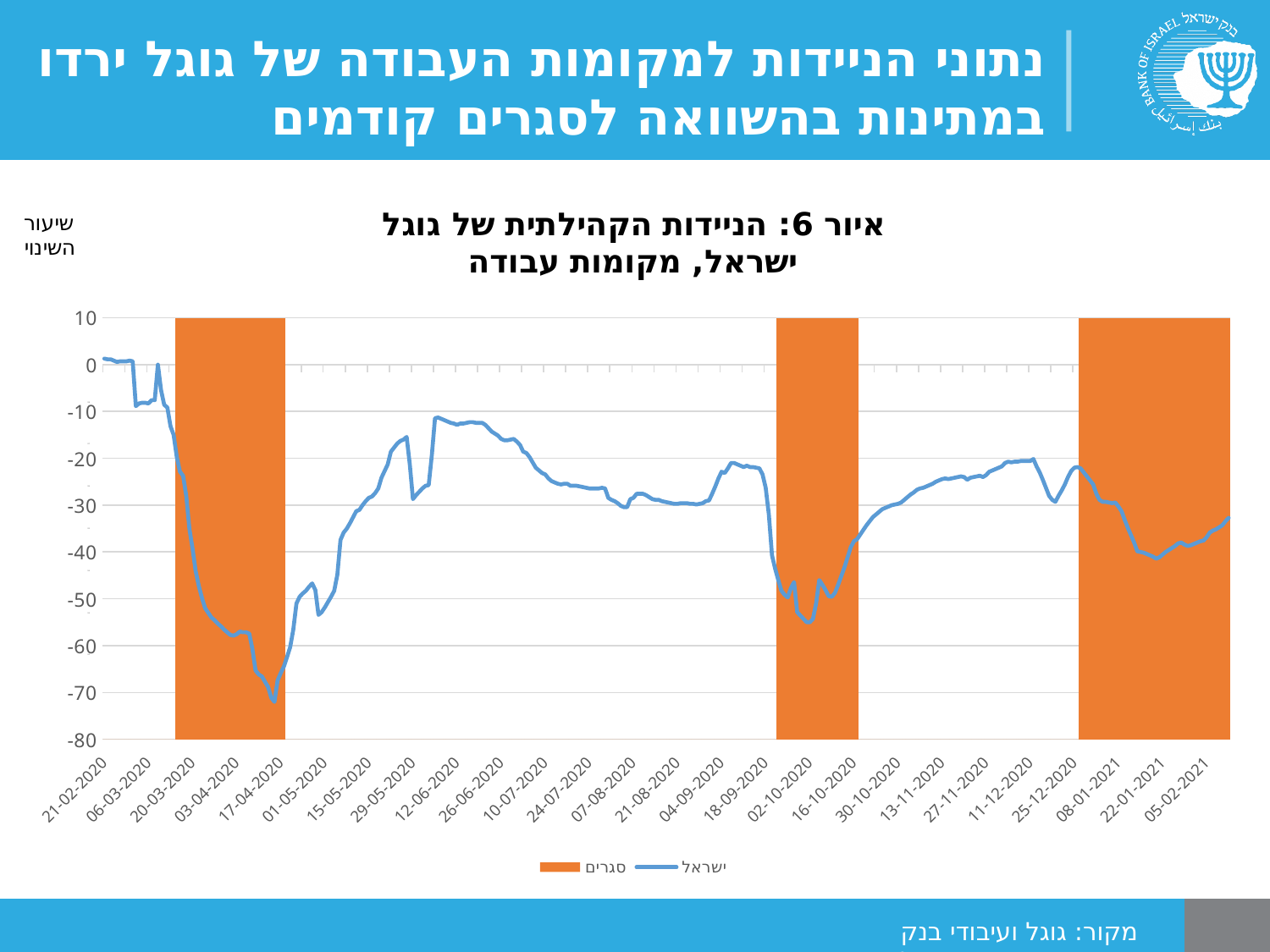
What is the title of the chart? איור 6: הניידות הקהילתית של גוגל ישראל, מקומות עבודה Is the value for ישראל at 05-02-2021 greater or less than -20? less How many entries does the legend list? 2 Does the line rise or fall between 17-04-2020 and 12-06-2020? rise Is the value for ישראל at 12-06-2020 greater or less than -20? greater Is the value for ישראל at 21-02-2020 greater or less than -10? greater How many orange shaded lockdown (סגרים) periods are marked on the chart? 3 What is the label on the y axis of the chart? שיעור השינוי During which of the three shaded lockdown periods does the line reach its lowest point? the first (March–April 2020) What kind of chart is shown on the slide? line chart